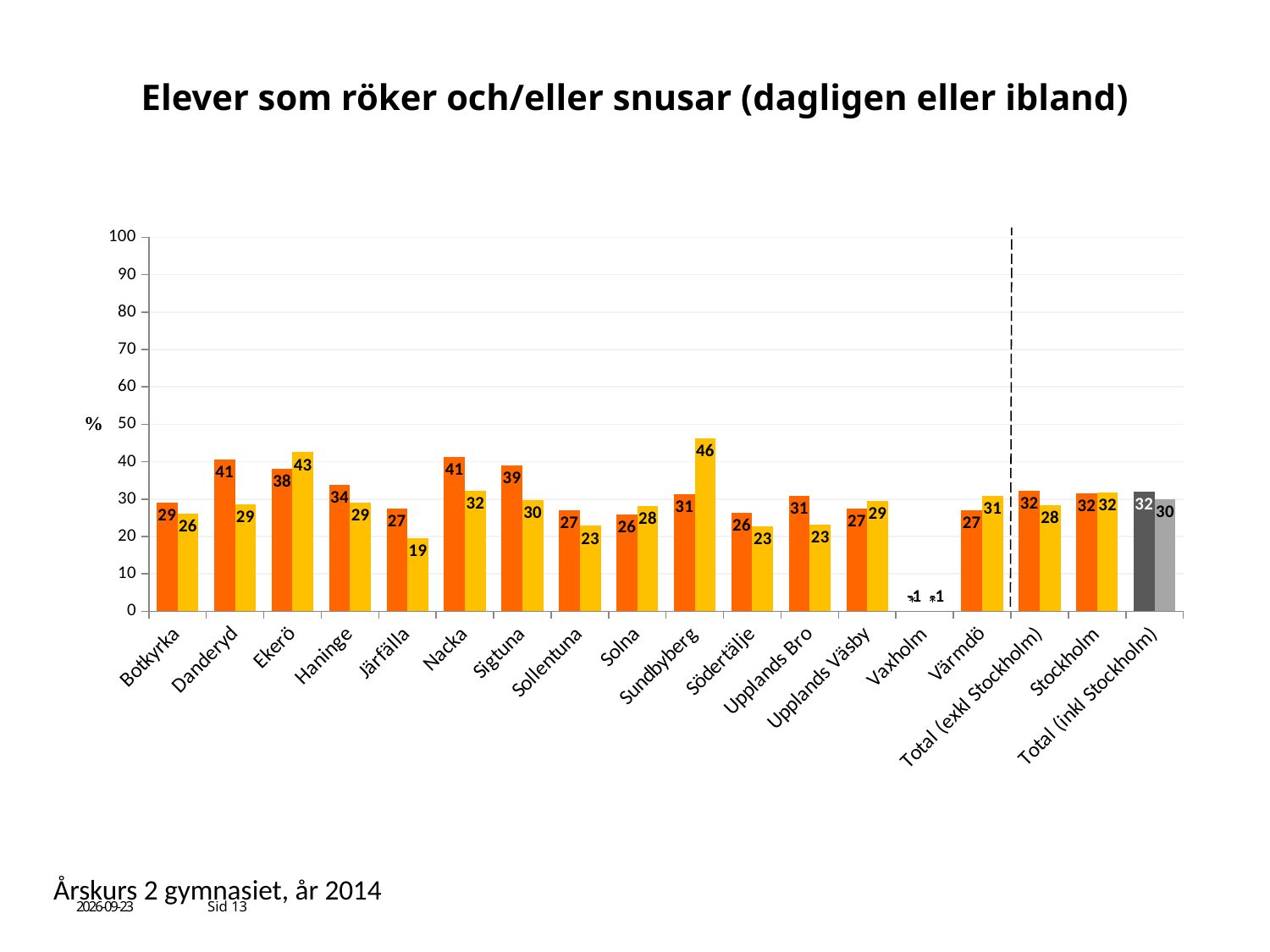
What is the value of the yellow bar for Järfälla? 19 What is the value of the orange bar for Total (exkl Stockholm)? 32 Which is larger for Ekerö, the orange bar or the yellow bar? the yellow bar What is the title of the chart? Elever som röker och/eller snusar (dagligen eller ibland) What is the value of the orange bar for Danderyd? 41 What is the value of the yellow bar for Sundbyberg? 46 Which municipality has the highest yellow bar? Sundbyberg What kind of chart is shown on the slide? bar chart What is the difference between the orange and yellow bars for Sundbyberg? 15 How many categories are shown on the x axis? 18 What is the difference between the orange bars for Danderyd and Botkyrka? 12 Among the municipalities with numeric labels, which has the lowest yellow bar? Järfälla